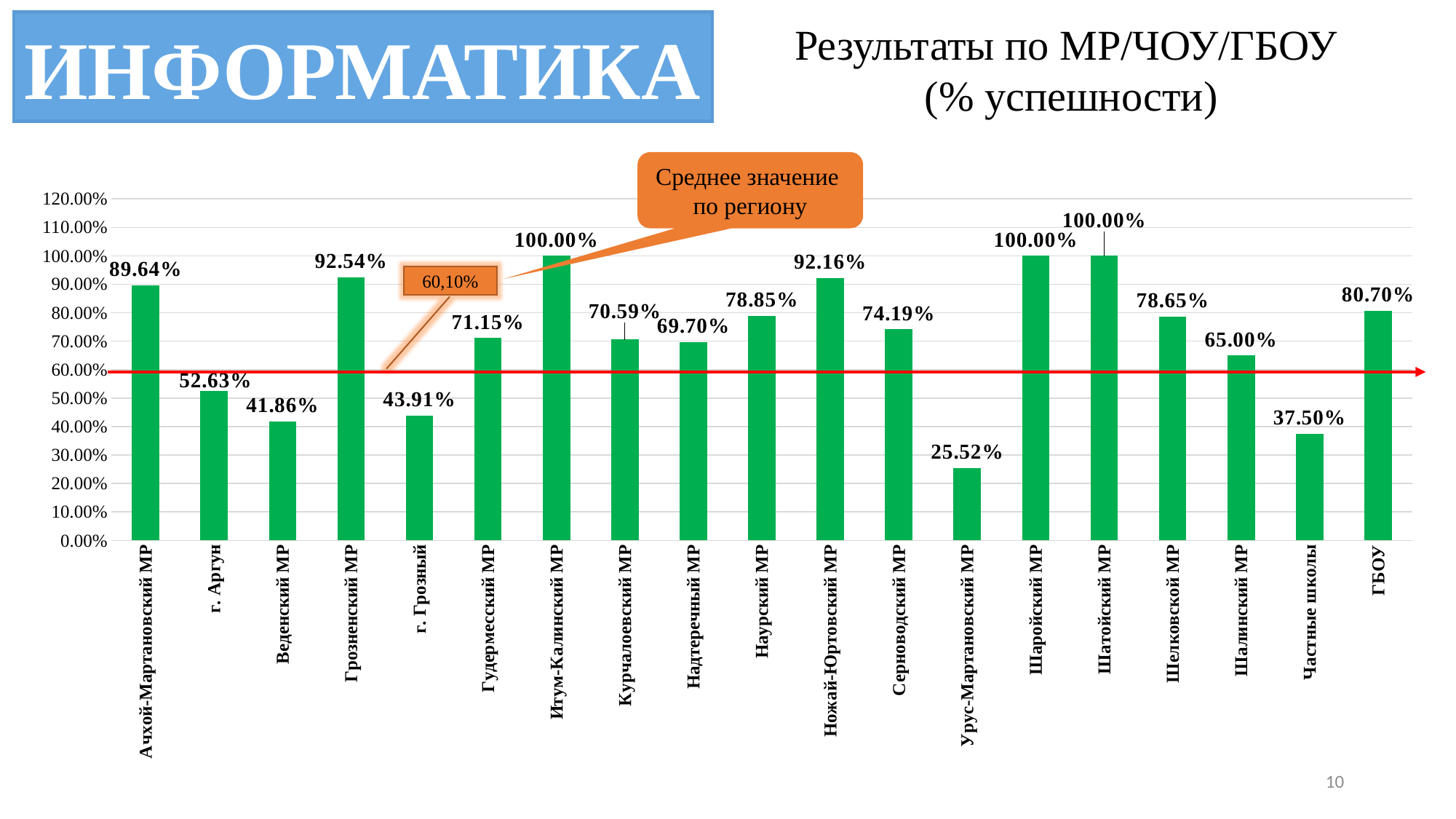
What is the difference between the values for Грозненский МР and г. Грозный? 48.63% What is the value for Урус-Мартановский МР? 25.52% What is the regional average value (Среднее значение по региону) marked on the chart? 60,10% What is the value for Частные школы? 37.50% What is the value for Ачхой-Мартановский МР? 89.64% What kind of chart is shown on the slide? bar chart Which category has the lowest value? Урус-Мартановский МР What is the value for ГБОУ? 80.70% How many categories have a value of 100.00%? 3 How many categories are shown on the x axis? 19 Is the value for Шалинский МР greater or less than 60.00%? greater Which is larger, the value for Наурский МР or the value for Шелковской МР? Наурский МР